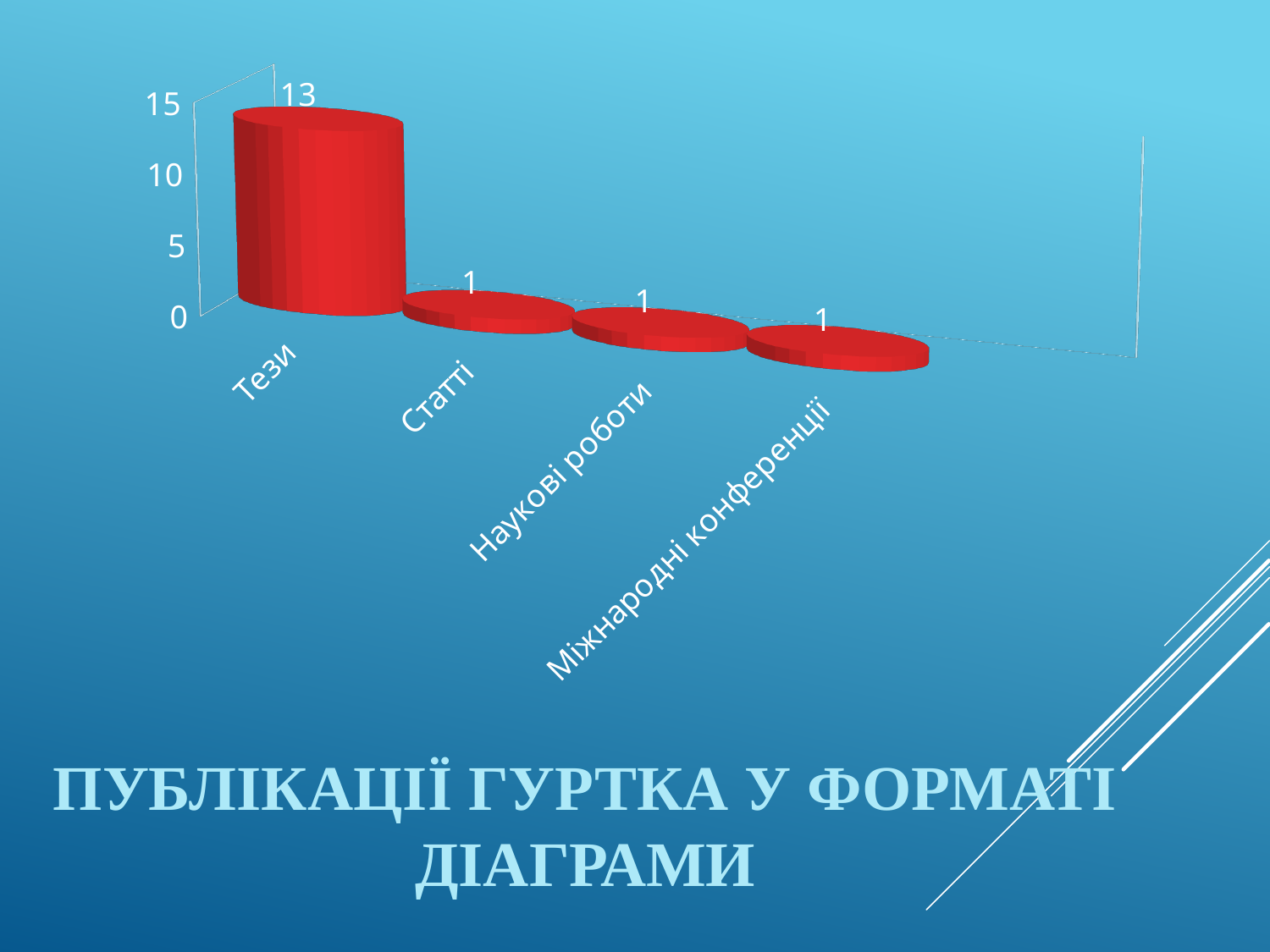
How many categories are shown on the chart? 4 Is the value for Міжнародні конференції greater or less than 5? less What is the title text shown on the slide? ПУБЛІКАЦІЇ ГУРТКА У ФОРМАТІ ДІАГРАМИ What is the value for Тези? 13 What is the difference between the values for Тези and Статті? 12 What kind of chart is shown on the slide? Bar chart Which category has the highest value? Тези What is the value for Міжнародні конференції? 1 Is the value for Тези greater or less than 10? greater What is the value for Наукові роботи? 1 What is the value for Статті? 1 Which is larger, the value for Тези or the value for Наукові роботи? Тези